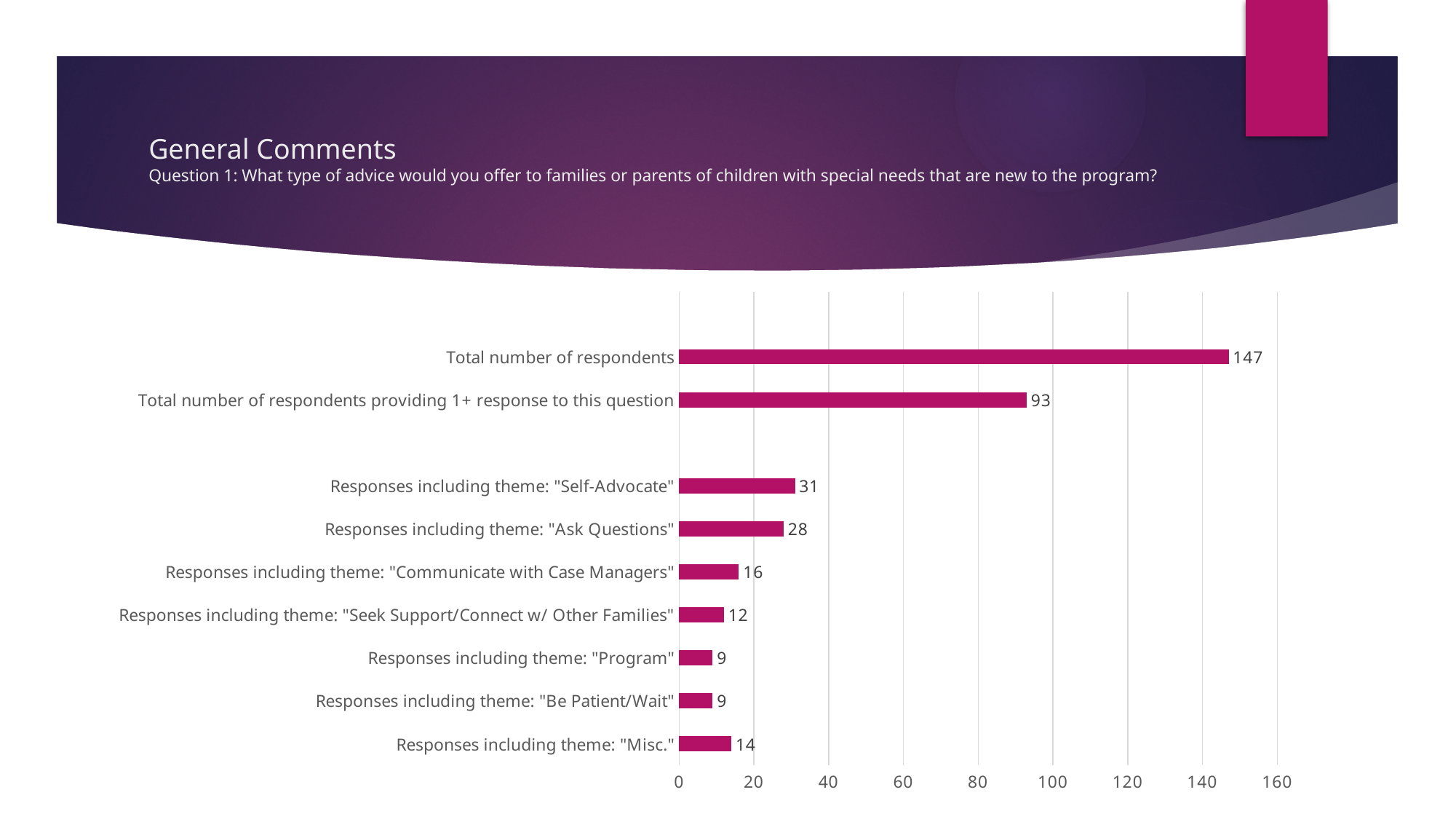
What is the difference between the total number of respondents and the number providing 1+ response to this question? 54 How many responses included the theme "Self-Advocate"? 31 What is the maximum value shown on the horizontal axis? 160 What is the difference between the "Self-Advocate" and "Ask Questions" theme counts? 3 What type of chart is shown on the slide? Bar chart How many responses included the theme "Communicate with Case Managers"? 16 Which has more responses: the "Misc." theme or the "Seek Support/Connect w/ Other Families" theme? Misc. What is the value for "Total number of respondents"? 147 Which theme category has the highest number of responses? Self-Advocate What is the value for "Total number of respondents providing 1+ response to this question"? 93 Which category has the lowest value on the chart? Program and Be Patient/Wait (both 9) How many categories (bars) are shown on the chart? 9